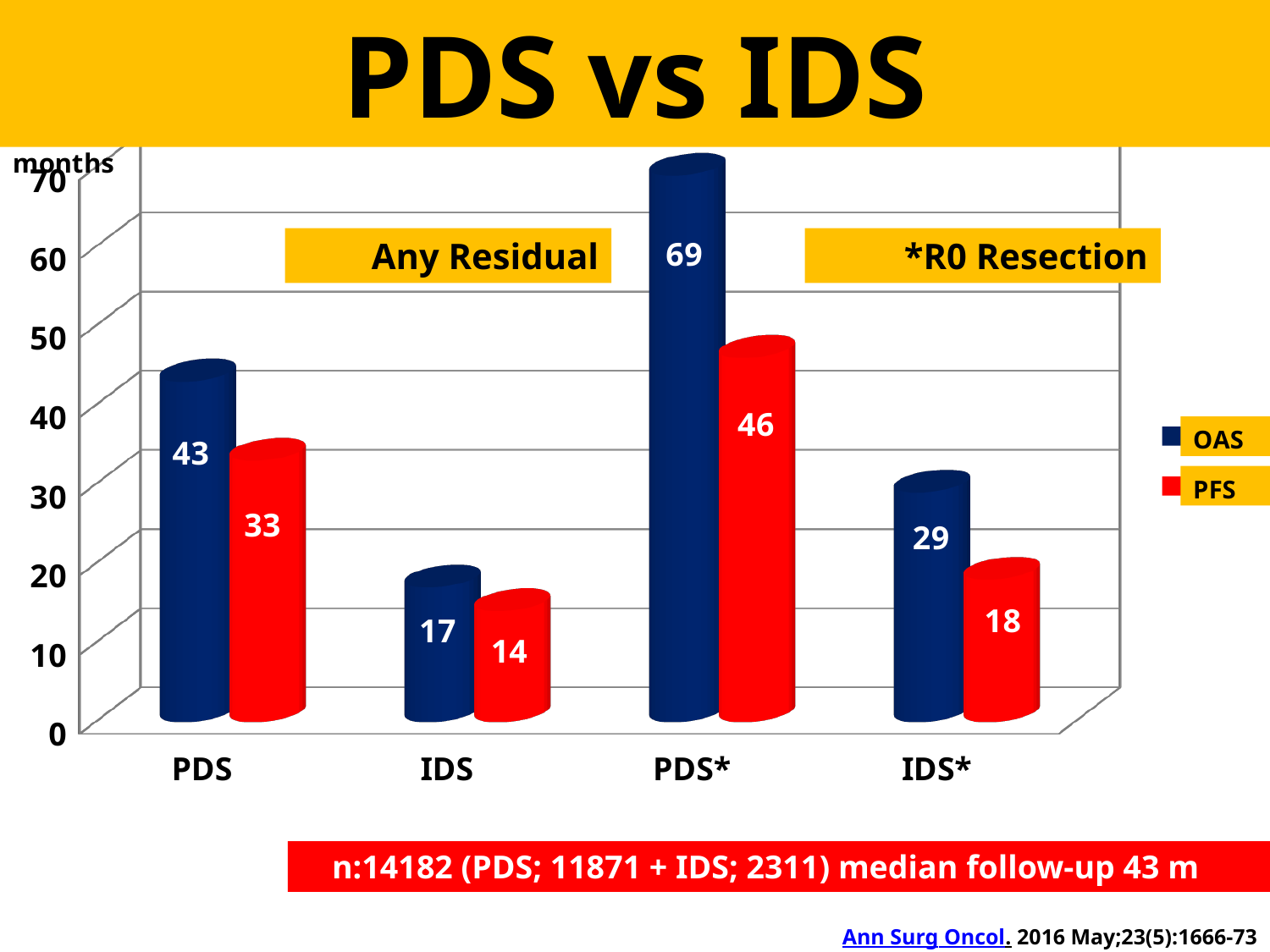
What is the OAS value for IDS*? 29 What is the difference between the OAS and PFS values for PDS? 10 What is the difference between the OAS values for PDS* and IDS*? 40 Which category has the highest OAS value? PDS* What unit is shown on the y axis of the chart? months Which is larger, the PFS value for PDS* or the OAS value for PDS? PFS value for PDS* How many categories are shown on the x axis? 4 What kind of chart is shown on the slide? Bar chart What is the PFS value for IDS? 14 What is the OAS value for PDS*? 69 Which category has the lowest PFS value? IDS How many series does the legend list? 2